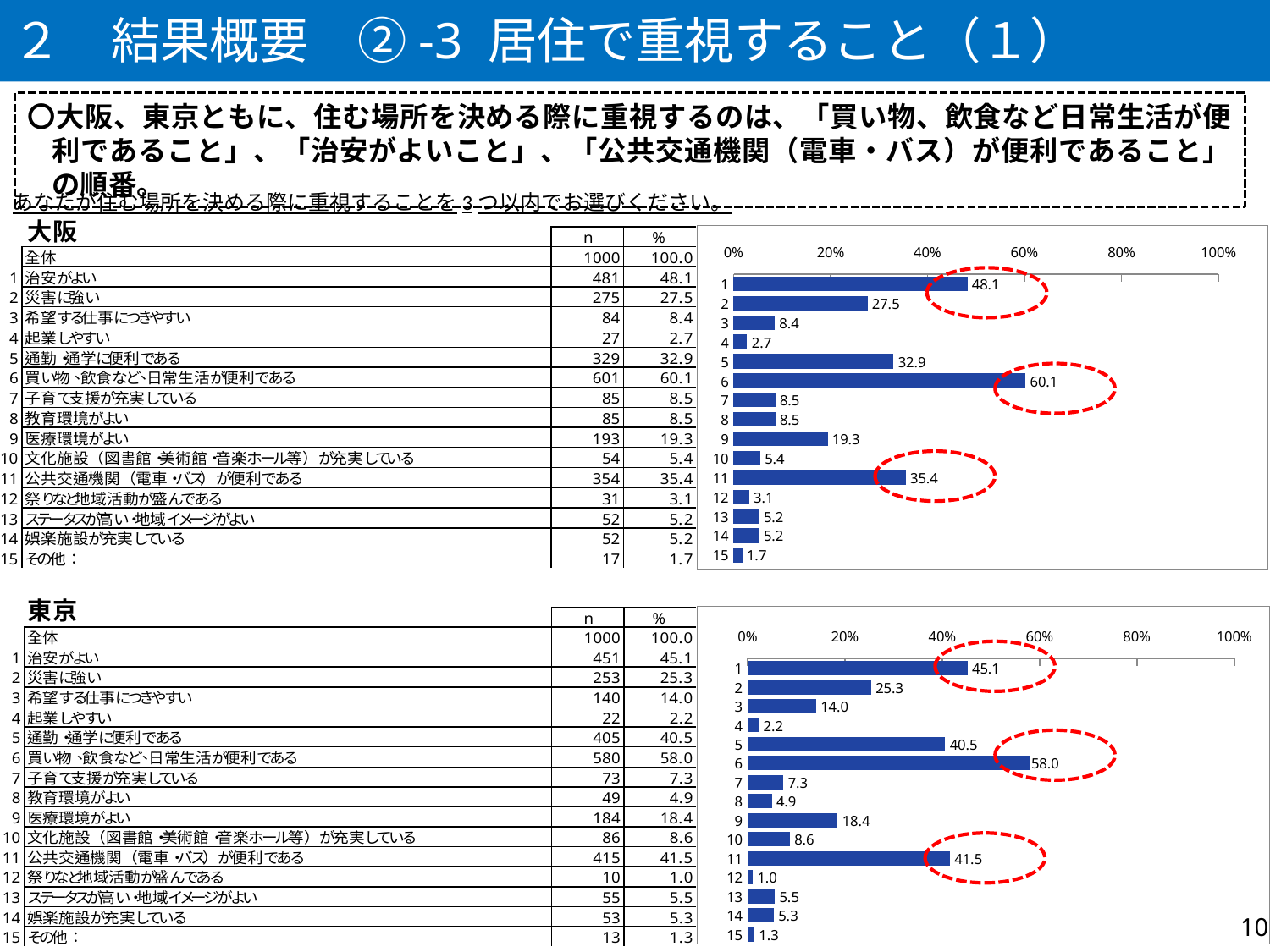
In the 大阪 (top) chart, which category has the highest value? 6 (買い物、飲食など日常生活が便利である) In the 東京 (bottom) chart, which category has the lowest value? 12 (祭りなど地域活動が盛んである) How many categories are plotted in the 東京 (bottom) chart? 15 In the 東京 (bottom) chart, which is larger: category 5 (通勤・通学に便利である) or category 11 (公共交通機関が便利である)? 11 (公共交通機関が便利である) In the 大阪 (top) chart, is the value for category 11 greater or less than 40%? less What type of chart is used for the 大阪 (top) data? bar chart In the 大阪 (top) chart, what is the difference between category 1 (治安がよい) and category 2 (災害に強い)? 20.6 In the 東京 (bottom) chart, what is the difference between category 6 (58.0) and category 1 (45.1)? 12.9 What is the maximum value shown on the x axis of the 東京 (bottom) chart? 100% In the 大阪 (top) chart, what is the value for category 6 (買い物、飲食など日常生活が便利である)? 60.1 In the 大阪 (top) chart, what is the value for category 15 (その他)? 1.7 In the 東京 (bottom) chart, what is the value for category 11 (公共交通機関が便利である)? 41.5